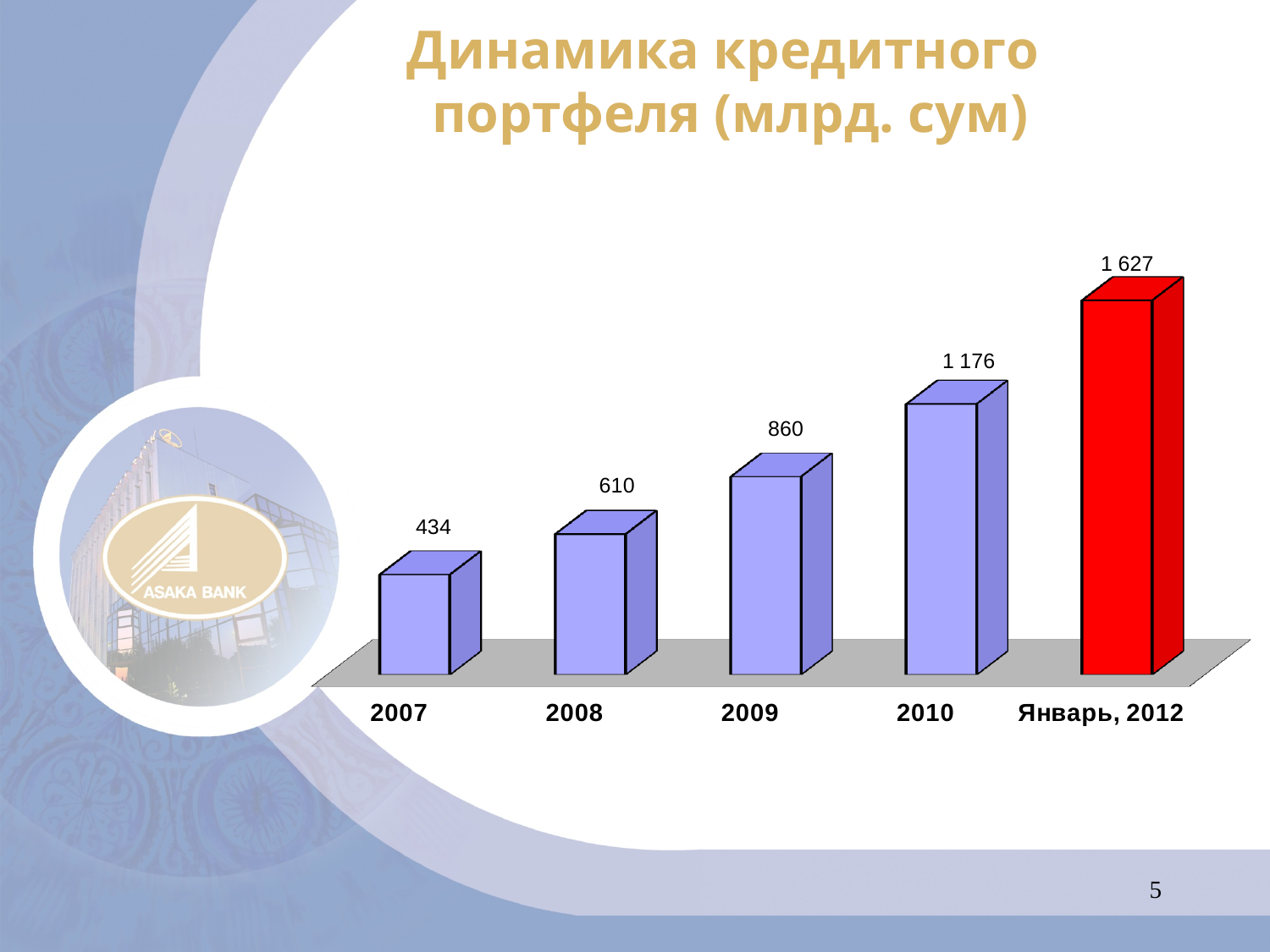
What kind of chart is shown on the slide? bar chart What is the value for Январь, 2012? 1 627 Which category has the highest value? Январь, 2012 What is the difference between the values for Январь, 2012 and 2007? 1 193 What is the value for 2009? 860 Which is larger, the value for 2008 or the value for 2010? 2010 What is the difference between the values for 2010 and 2009? 316 What is the title of the chart? Динамика кредитного портфеля (млрд. сум) How many bars are shown in the chart? 5 Do the values rise or fall from 2007 to Январь, 2012? rise What is the value for 2007? 434 Which category has the lowest value? 2007